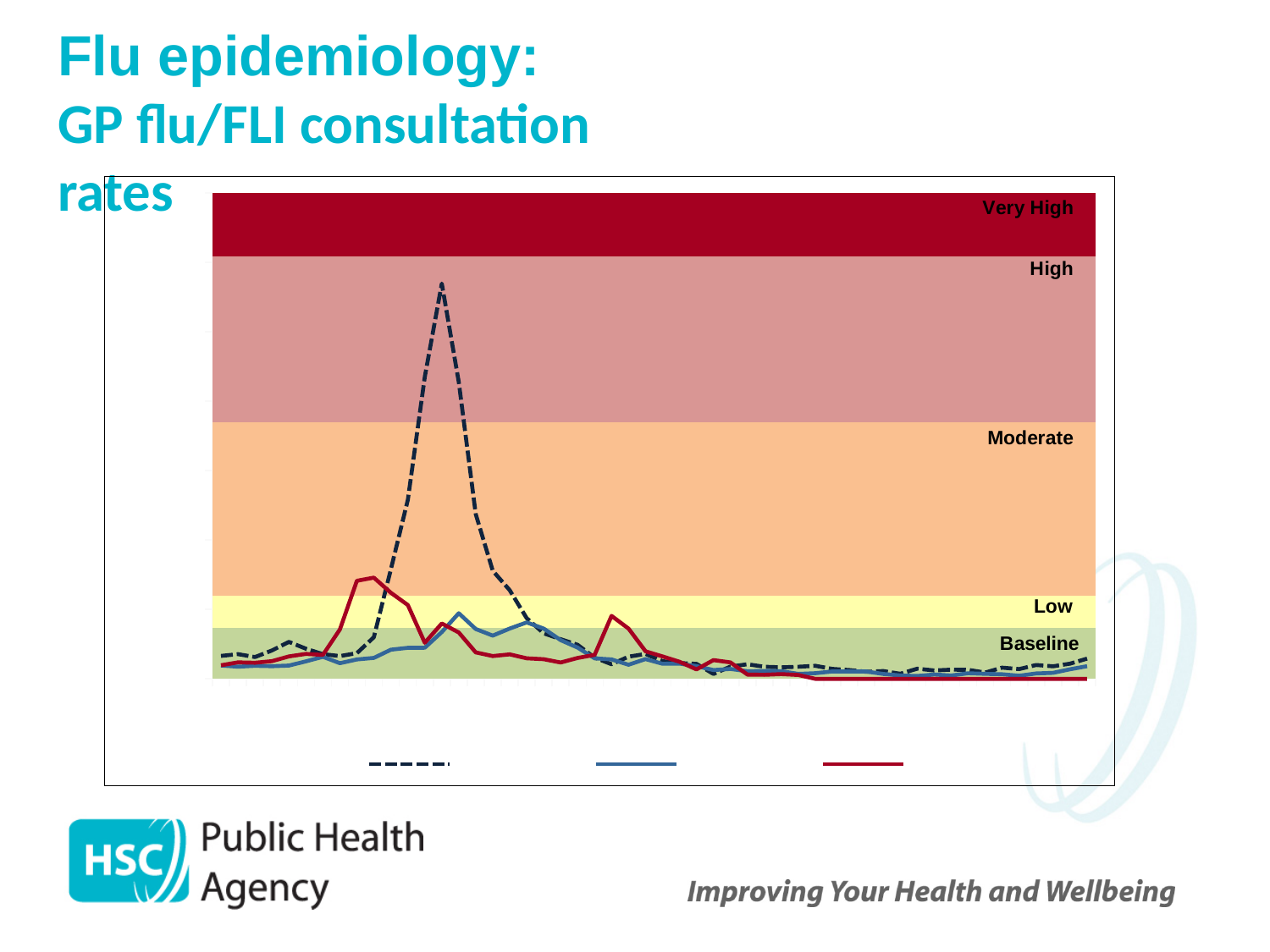
Does any line reach the Very High band? No Which shaded band does the peak of the blue line reach? Low Which peaks higher, the dashed line or the red line? The dashed line Which peaks higher, the red line or the blue line? The red line After its peak, does the dashed line rise or fall towards the right of the chart? Fall How many series does the legend below the chart list? 3 Which shaded band is at the top of the chart? Very High Which shaded band does the peak of the dashed line reach? High What kind of chart is shown on the slide? Line chart Which line reaches the highest peak on the chart? The dashed line What are the labels of the shaded bands on the chart, from top to bottom? Very High, High, Moderate, Low, Baseline